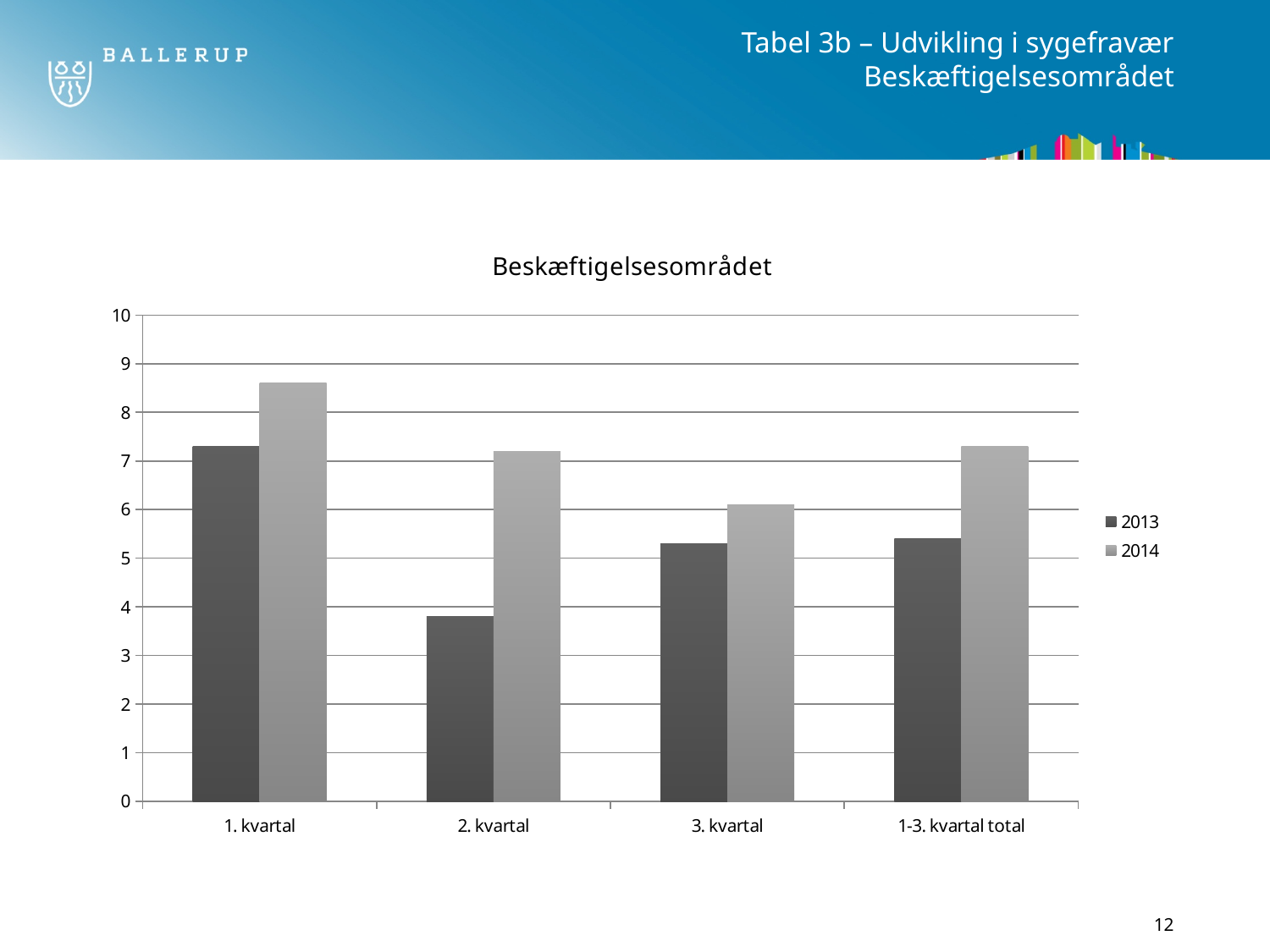
Which category has the lowest value for the 2014 series? 3. kvartal Which category has the highest value for the 2013 series? 1. kvartal How many series does the legend list? 2 Is the value for 2013 in 2. kvartal greater or less than 5? less How many categories are shown on the x axis? 4 What type of chart is shown on the slide? bar chart Is the value for 2014 in 1. kvartal greater or less than 8? greater Which category has the highest value for the 2014 series? 1. kvartal Do the 2014 values rise or fall from 1. kvartal to 3. kvartal? fall Is the value for 2014 in 1-3. kvartal total greater or less than 6? greater In 2. kvartal, which series has the larger value, 2013 or 2014? 2014 Which category has the lowest value for the 2013 series? 2. kvartal